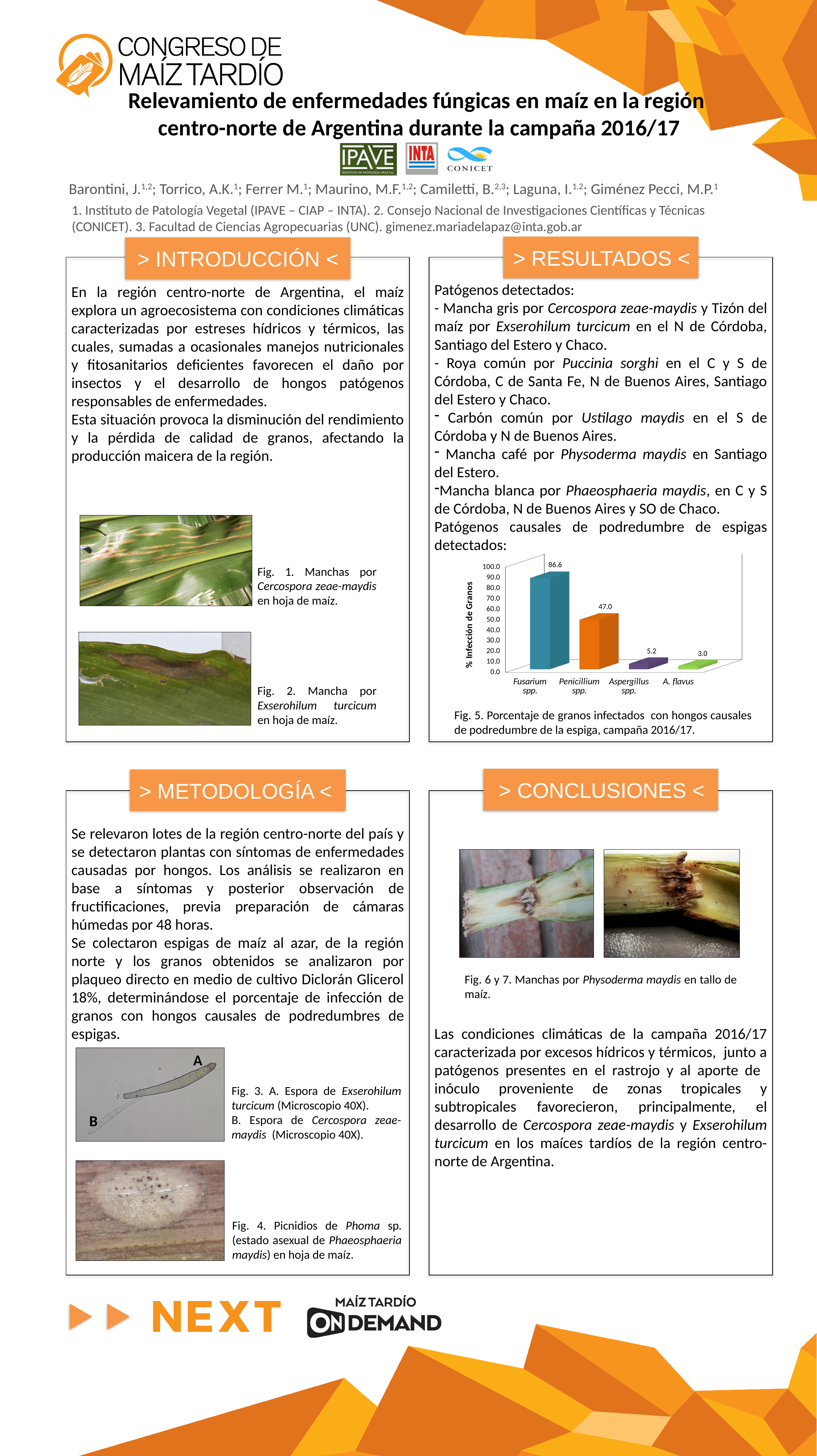
Which fungus has the lowest percentage of grain infection in the chart? A. flavus Is the value for Penicillium spp. greater or less than 50.0? less What is the percentage of grain infection for Penicillium spp. in the chart? 47.0 How many fungal categories are shown in the chart? 4 What type of chart is used to show the percentage of infected grains? bar chart Which has a higher infection percentage, Aspergillus spp. or A. flavus? Aspergillus spp. Which fungus has the highest percentage of grain infection in the chart? Fusarium spp. What is the percentage of grain infection for Fusarium spp. in the chart? 86.6 What is the label of the vertical axis of the chart? % Infección de Granos What is the percentage of grain infection for Aspergillus spp. in the chart? 5.2 What is the difference between the infection percentages for Fusarium spp. and Penicillium spp.? 39.6 What is the percentage of grain infection for A. flavus in the chart? 3.0